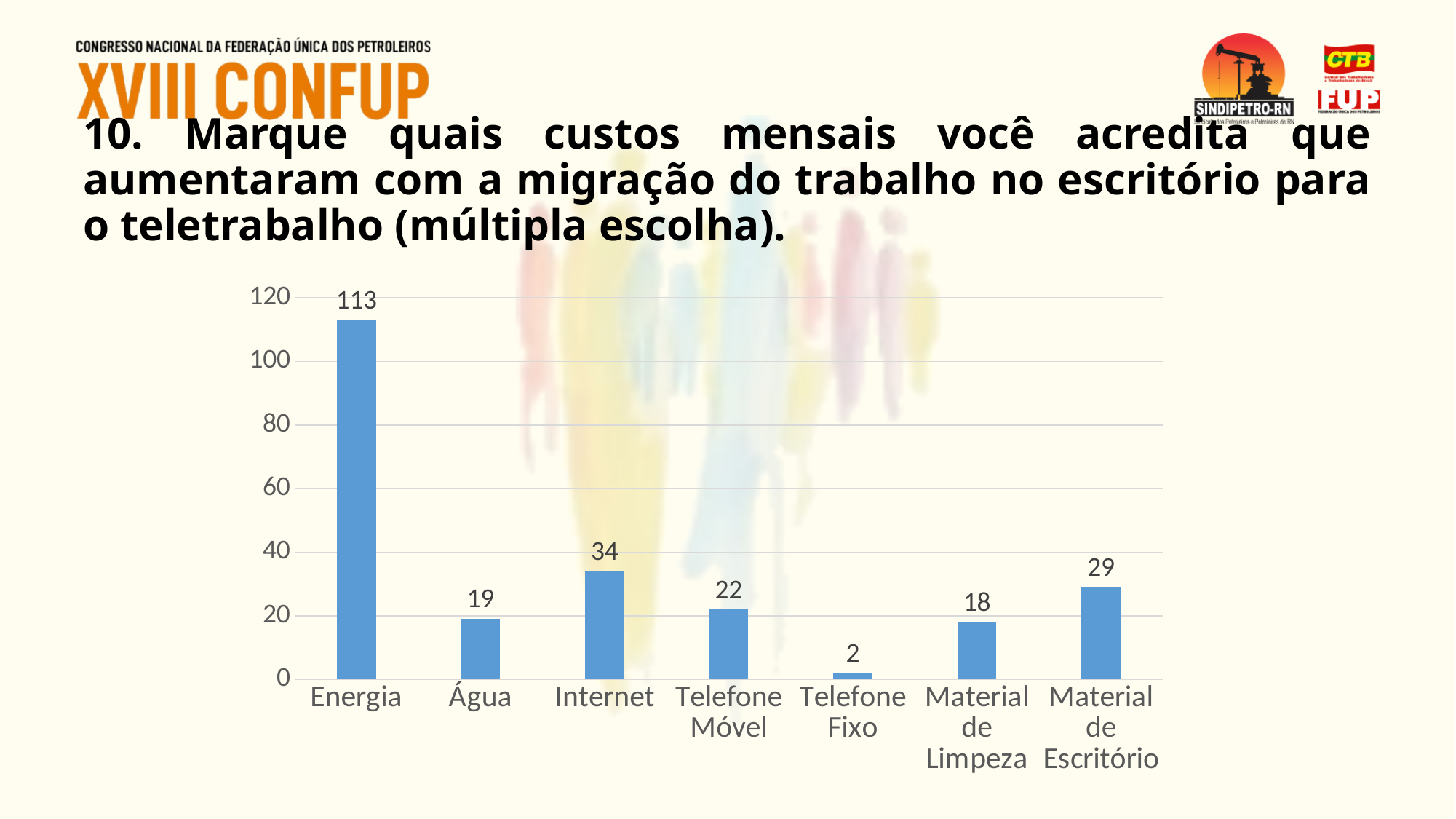
How many categories are shown on the x axis? 7 Is the value for Energia greater or less than 100? greater What is the value for Material de Escritório? 29 What is the value for Telefone Fixo? 2 Which is larger, the value for Água or the value for Telefone Móvel? Telefone Móvel Which category has the lowest value? Telefone Fixo What kind of chart is shown on the slide? bar chart What is the difference between the values for Material de Escritório and Material de Limpeza? 11 Which category has the highest value? Energia What is the value for Energia? 113 What is the value for Internet? 34 What is the difference between the values for Energia and Internet? 79